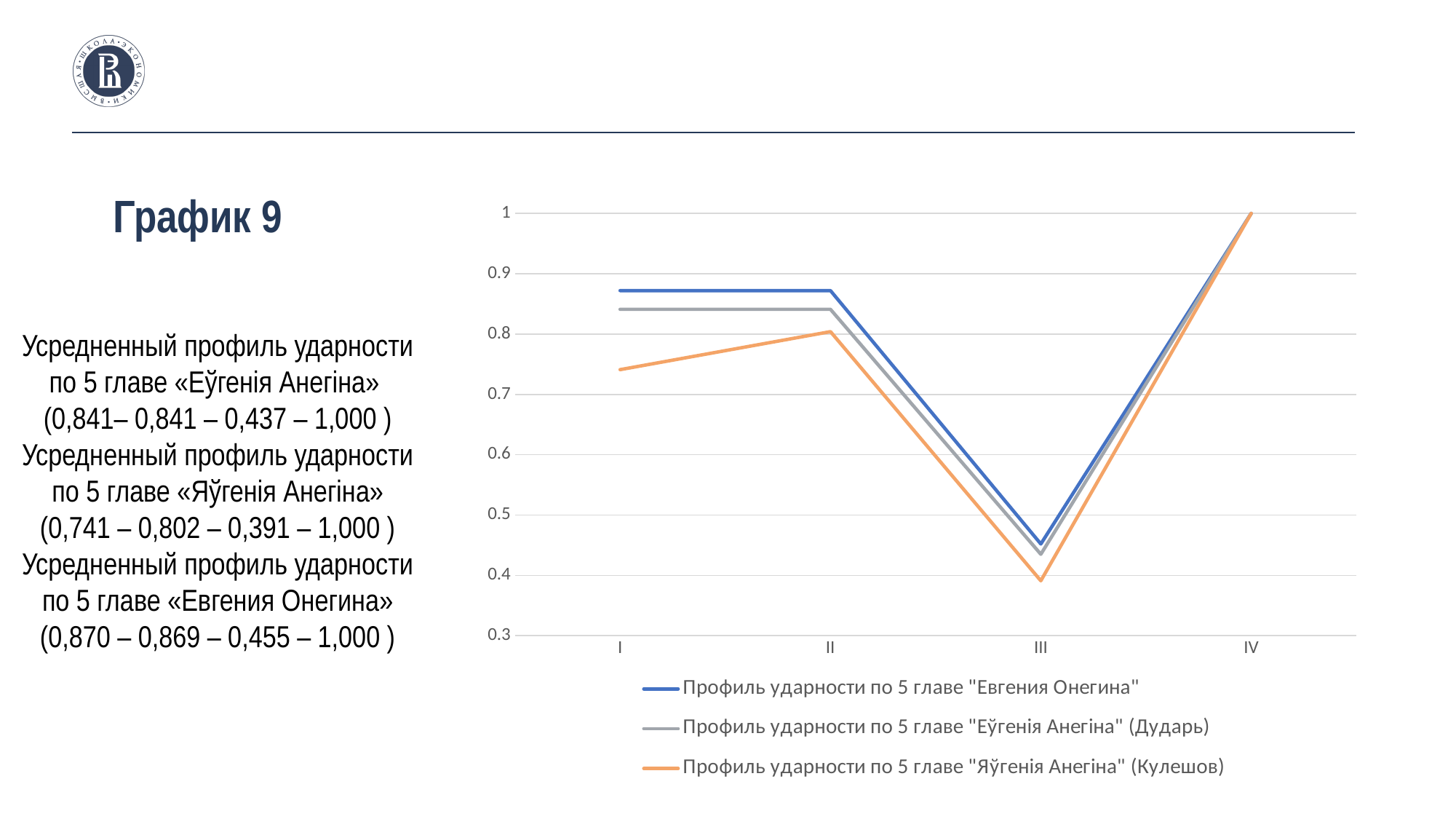
How many points are on the x axis of the chart? 4 What kind of chart is shown on the slide? line chart What value do all three series reach at point IV? 1 What colour is the line for "Евгения Онегина" in the legend? blue How many series does the legend list? 3 Do the series rise or fall from point III to point IV? rise According to the slide text, what is the value at point III for the profile of "Евгения Онегина"? 0,455 Which series has the lowest value at point I? Профиль ударности по 5 главе "Яўгенія Анегіна" (Кулешов) According to the slide text, what is the value at point II for the profile of "Яўгенія Анегіна" (Кулешов)? 0,802 At which x-axis point do all three series reach their lowest value? III Is the value for "Евгения Онегина" at point I greater or less than 0.8? greater